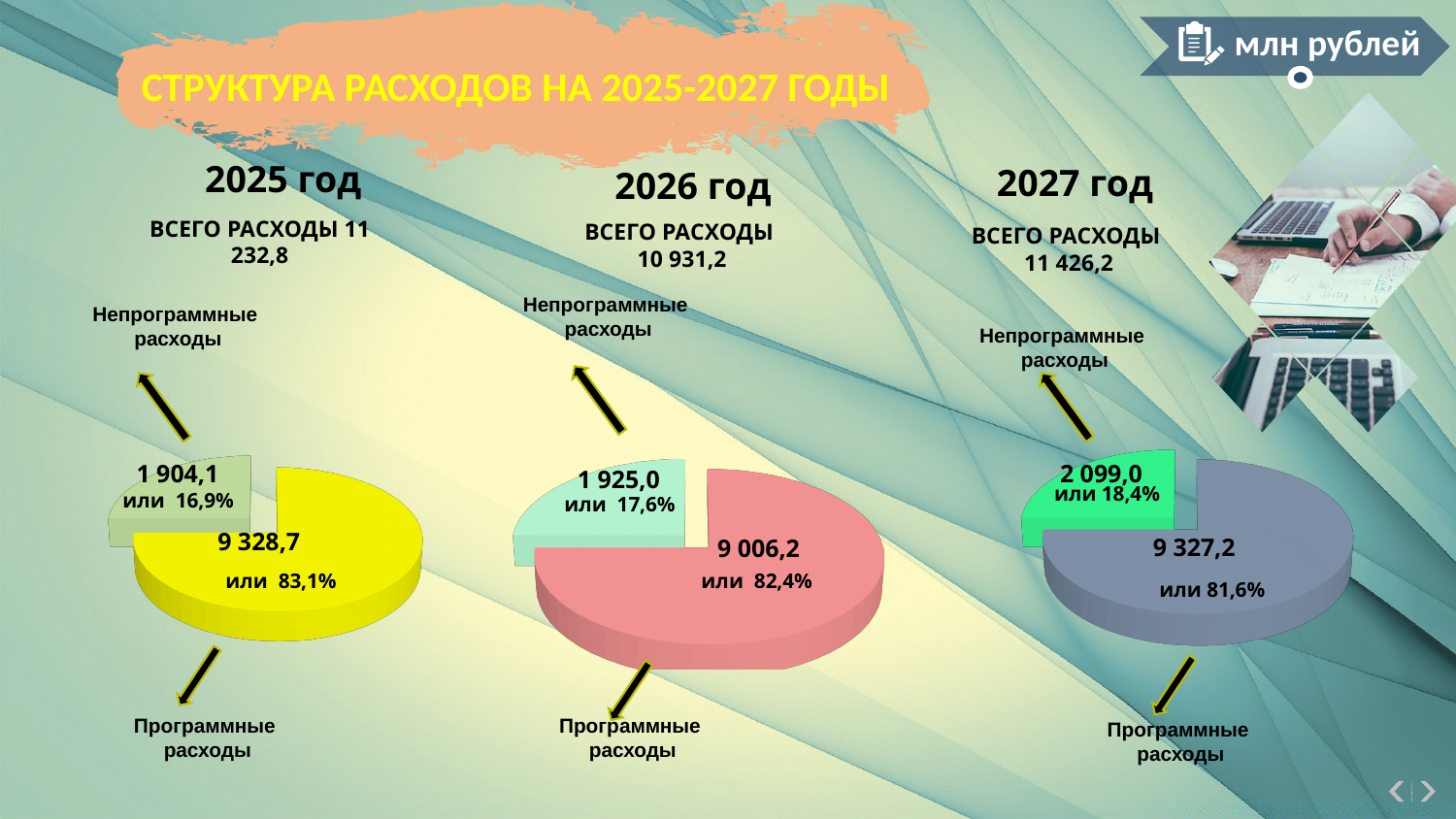
In the 2026 pie chart, what is the value for Непрограммные расходы? 1 925,0 In the 2027 pie chart, which slice is the largest? Программные расходы In the 2026 pie chart, what share of the pie is Программные расходы? 82,4% In the 2027 pie chart, what is the value for Программные расходы? 9 327,2 How many pie charts are shown on the slide? 3 In the 2025 pie chart, what share of the pie is Непрограммные расходы? 16,9% In the 2025 pie chart, which slice is the smallest? Непрограммные расходы In the 2025 pie chart, what is the value for Программные расходы? 9 328,7 In the 2026 pie chart, which is larger: Программные расходы or Непрограммные расходы? Программные расходы How many slices does the 2026 pie chart have? 2 In the 2027 pie chart, what share of the pie is Непрограммные расходы? 18,4% What kind of chart is used for the 2025 data? Pie chart